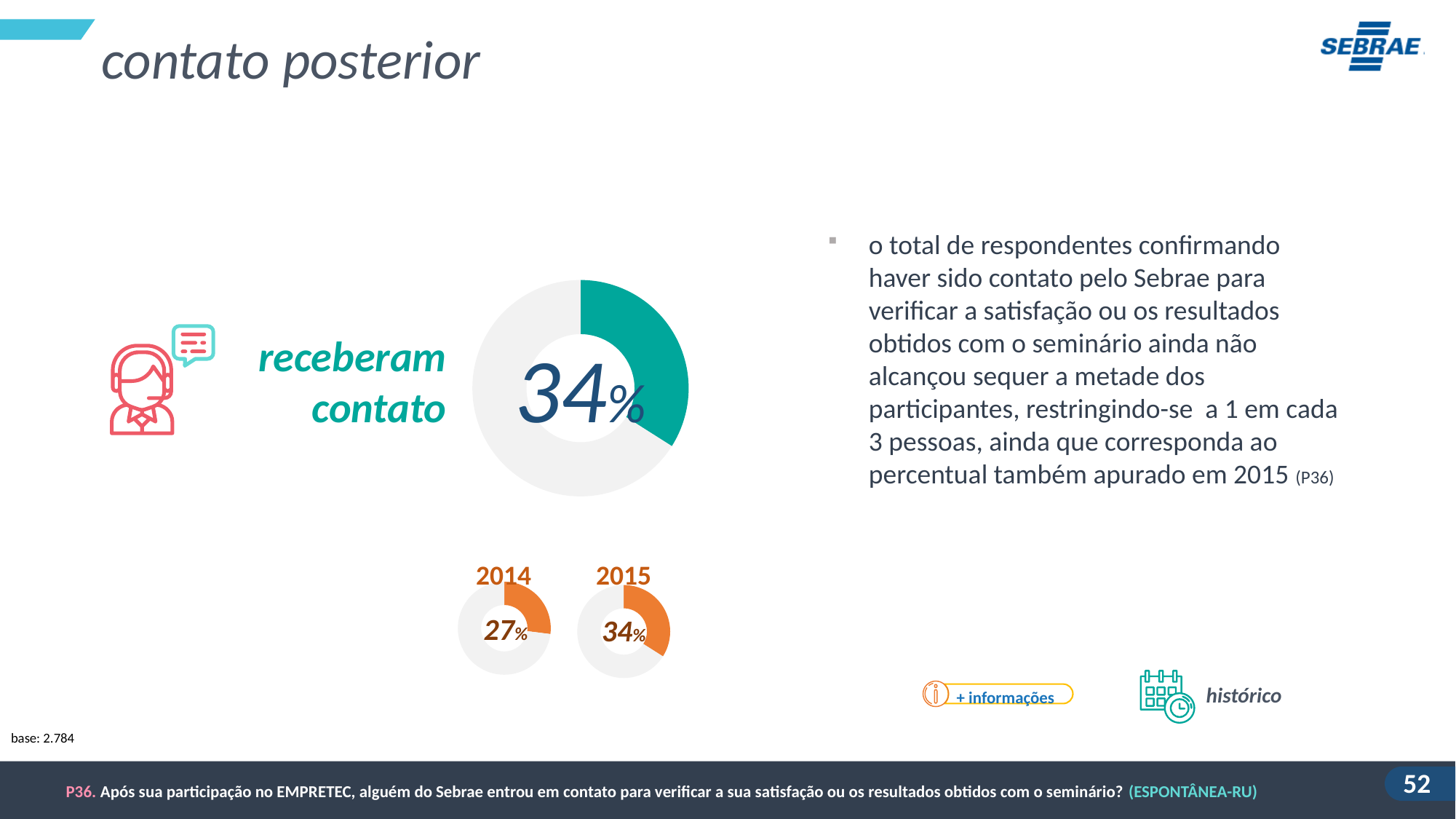
On the large donut chart, is the value for "receberam contato" greater or less than 50%? less What kind of chart is the large chart next to "receberam contato"? Donut chart Across the small donut charts, does the percentage rise or fall from 2014 to 2015? Rise On the small donut chart for 2014, what percentage is shown? 27% On the small donut chart for 2015, what percentage is shown? 34% On the large donut chart labelled "receberam contato", what percentage is shown? 34% How many small year-labelled donut charts are shown below the large donut chart? 2 What colour is the filled segment of the large "receberam contato" donut chart? Teal (green) What colour are the filled segments of the small 2014 and 2015 donut charts? Orange What is the difference in percentage points between the 2015 and 2014 small donut charts? 7 Comparing the small donut charts, which year has the lowest percentage? 2014 Comparing the small donut charts, which year has the higher percentage, 2014 or 2015? 2015